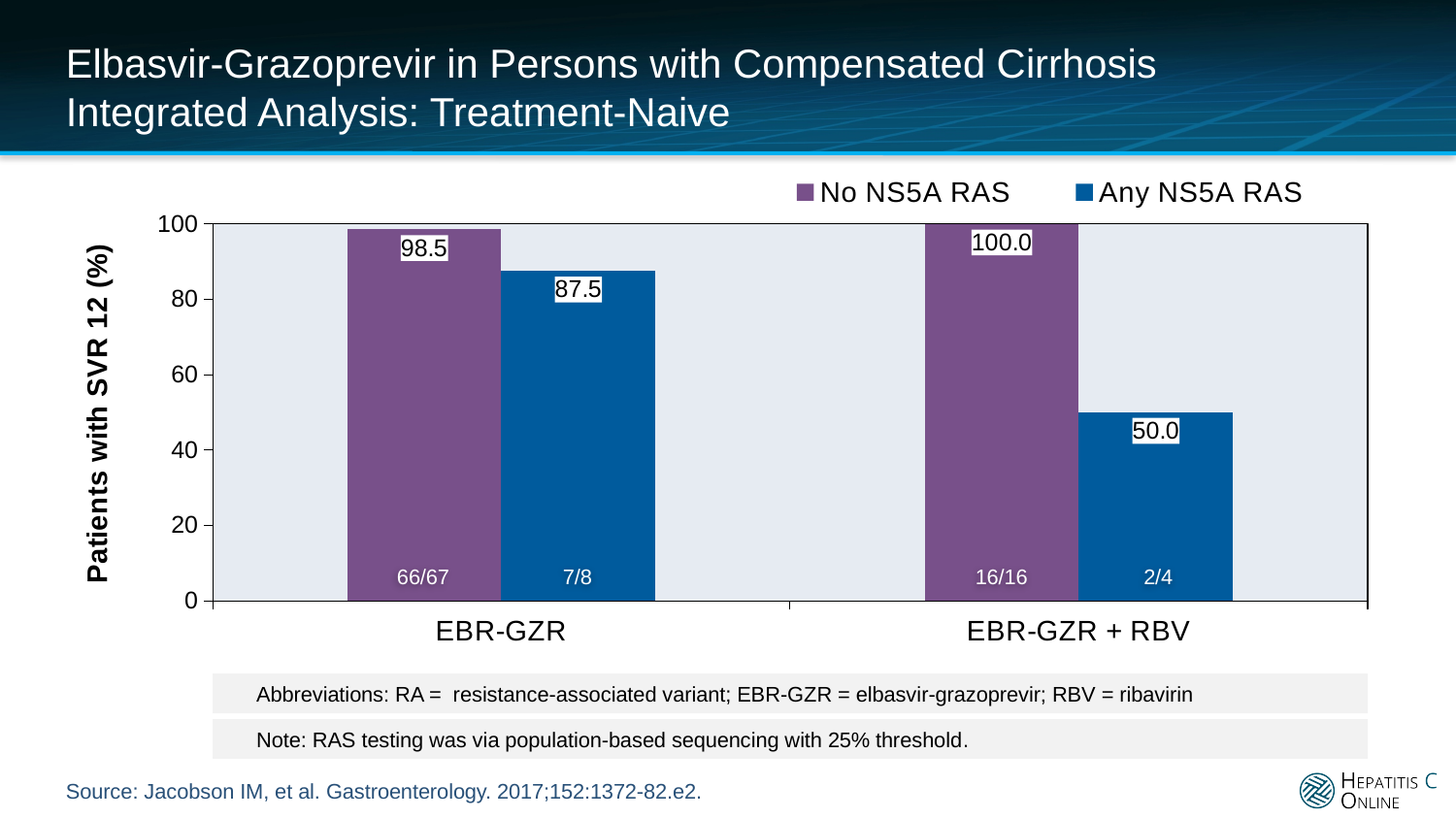
What is the SVR 12 rate for the No NS5A RAS group in the EBR-GZR arm? 98.5 How many series does the legend list? 2 What is the SVR 12 rate for the Any NS5A RAS group in the EBR-GZR arm? 87.5 What fraction of patients is shown for the No NS5A RAS group in the EBR-GZR + RBV arm? 16/16 What is the difference in SVR 12 rate between the No NS5A RAS and Any NS5A RAS groups in the EBR-GZR arm? 11.0 How many treatment arms are shown on the x axis? 2 Which is larger: the Any NS5A RAS rate in the EBR-GZR arm or the Any NS5A RAS rate in the EBR-GZR + RBV arm? EBR-GZR Which bar has the lowest SVR 12 rate? Any NS5A RAS in EBR-GZR + RBV What is the difference in SVR 12 rate between the No NS5A RAS and Any NS5A RAS groups in the EBR-GZR + RBV arm? 50.0 What kind of chart is shown on the slide? Bar chart What is the SVR 12 rate for the Any NS5A RAS group in the EBR-GZR + RBV arm? 50.0 Which bar has the highest SVR 12 rate? No NS5A RAS in EBR-GZR + RBV